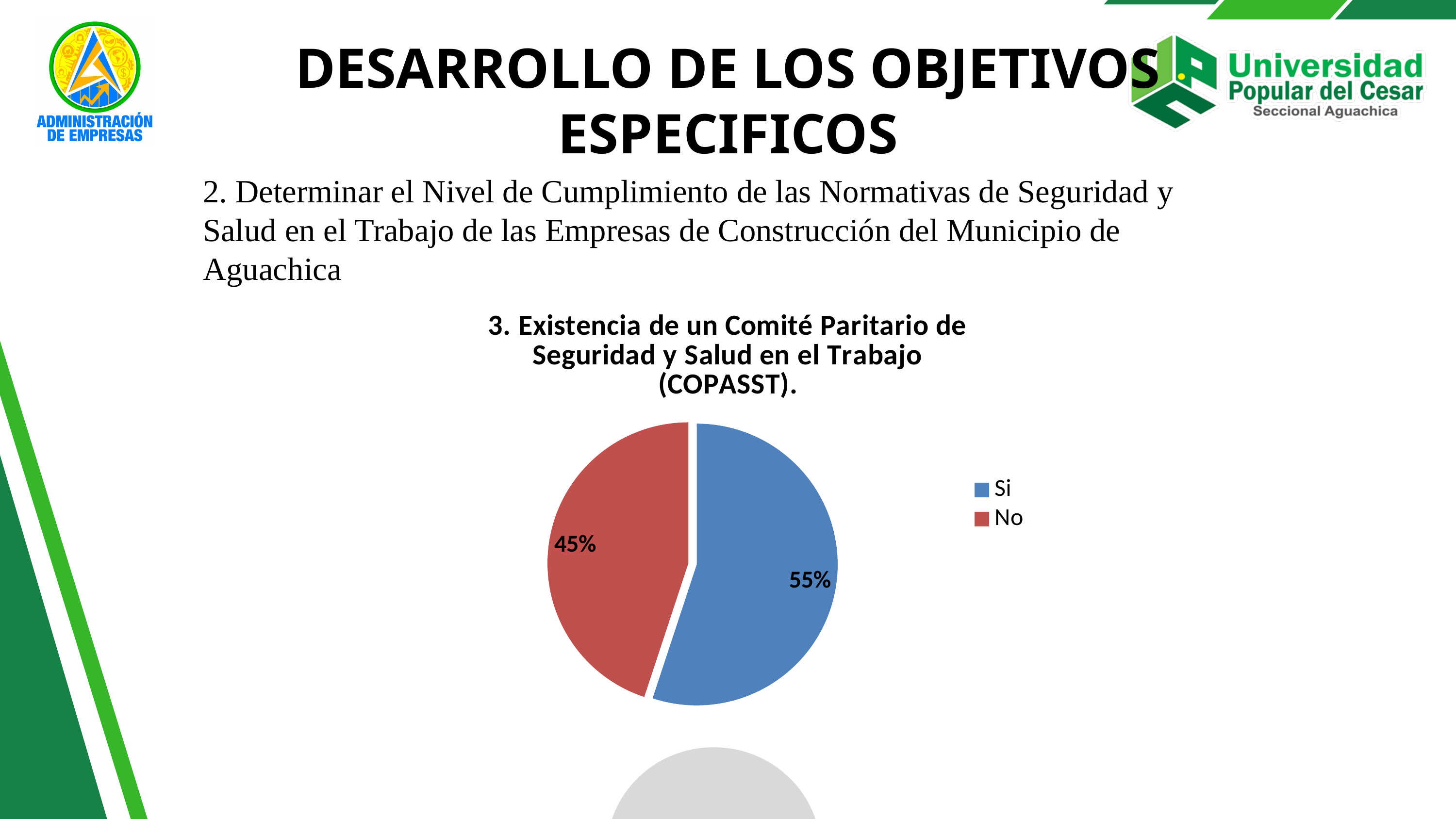
What percentage of the pie corresponds to "Si"? 55% What colour is the "No" slice in the pie chart? red What is the title of the pie chart? 3. Existencia de un Comité Paritario de Seguridad y Salud en el Trabajo (COPASST). Which category has the smallest share of the pie? No Which slice is larger, "Si" or "No"? Si How many slices does the pie chart have? 2 Which category has the largest share of the pie? Si What is the difference in percentage points between the "Si" and "No" slices? 10 What percentage of the pie corresponds to "No"? 45% What kind of chart is shown on the slide? pie chart How many entries does the legend list? 2